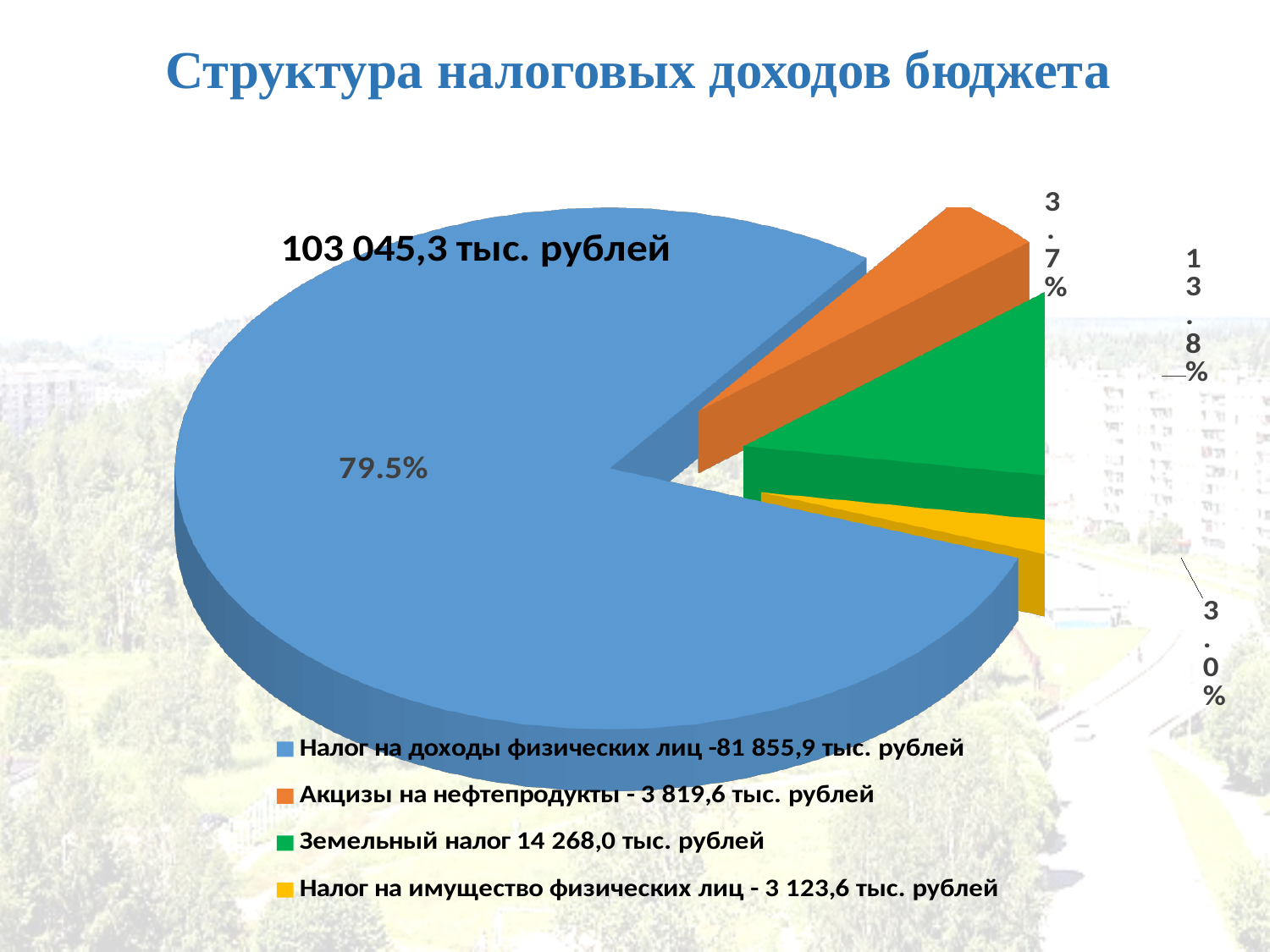
How many entries does the legend list? 4 What is the difference in percentage points between the share for Налог на доходы физических лиц and the share for Земельный налог? 65.7 How many slices does the pie chart have? 4 What share of the pie is labelled for Налог на доходы физических лиц? 79.5% Which is larger: the share for Земельный налог or the share for Акцизы на нефтепродукты? Земельный налог What kind of chart is shown on the slide? Pie chart What share of the pie is labelled for Земельный налог? 13.8% Which category has the largest slice of the pie? Налог на доходы физических лиц Which category has the smallest slice of the pie? Налог на имущество физических лиц What total amount is printed on the chart? 103 045,3 тыс. рублей What share of the pie is labelled for Акцизы на нефтепродукты? 3.7%